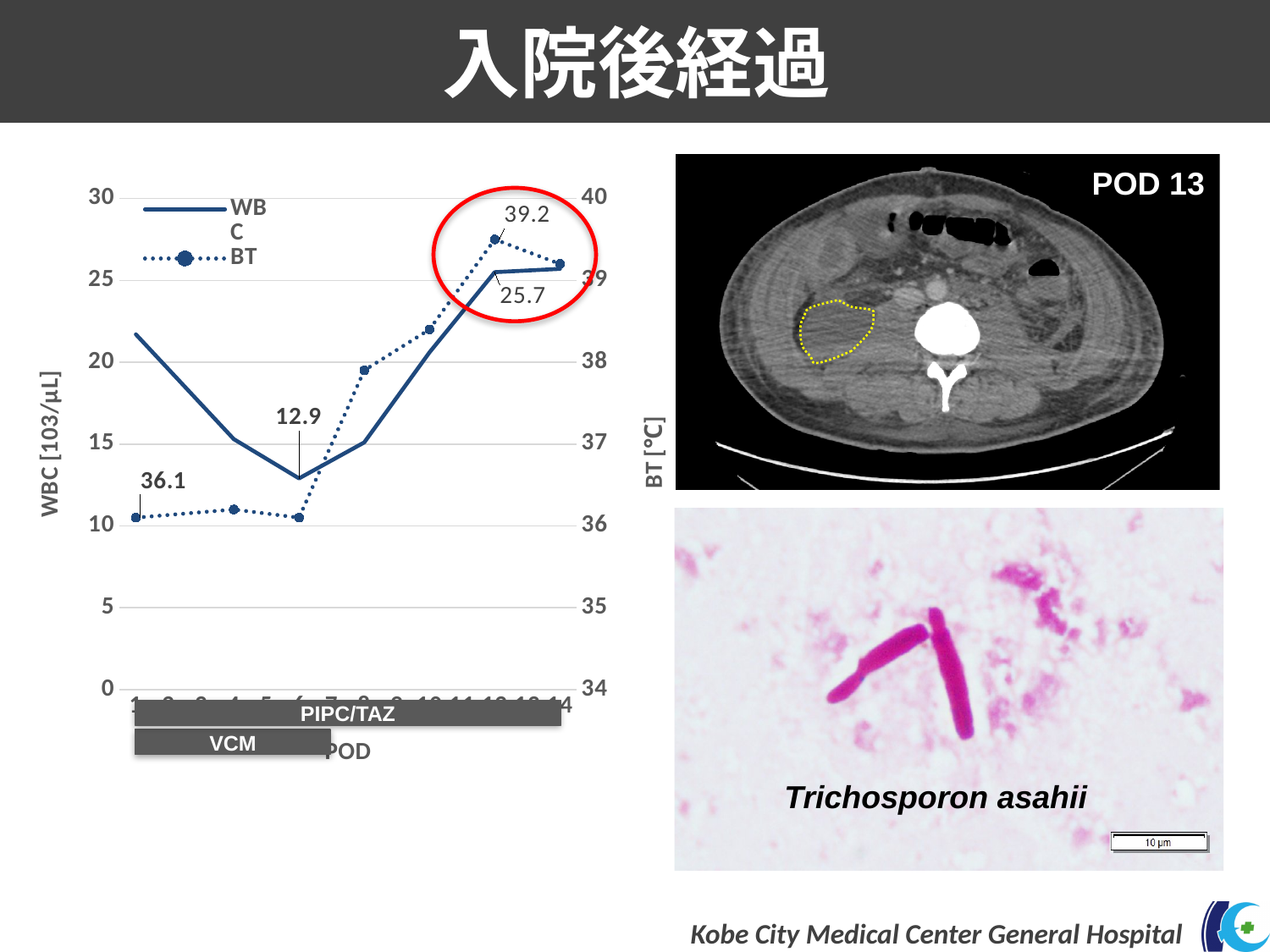
Does the WBC line rise or fall between the point labeled 12.9 and the point labeled 25.7? rise What is the difference between the labeled BT values 39.2 and 36.1? 3.1 Is the WBC value at the first point of the solid line greater or less than 20? greater What is the difference between the labeled WBC values 25.7 and 12.9? 12.8 Which labeled BT value is larger, 39.2 or 36.1? 39.2 What is the highest labeled BT value on the chart? 39.2 What is the label of the right-hand vertical axis of the chart? BT [°C] How many series does the legend of the line chart list? 2 What is the lowest labeled WBC value on the chart? 12.9 What WBC value is labeled inside the red circle on the chart? 25.7 What is the BT value labeled at the first point of the dotted BT line? 36.1 What kind of chart is shown on the left of the slide? line chart